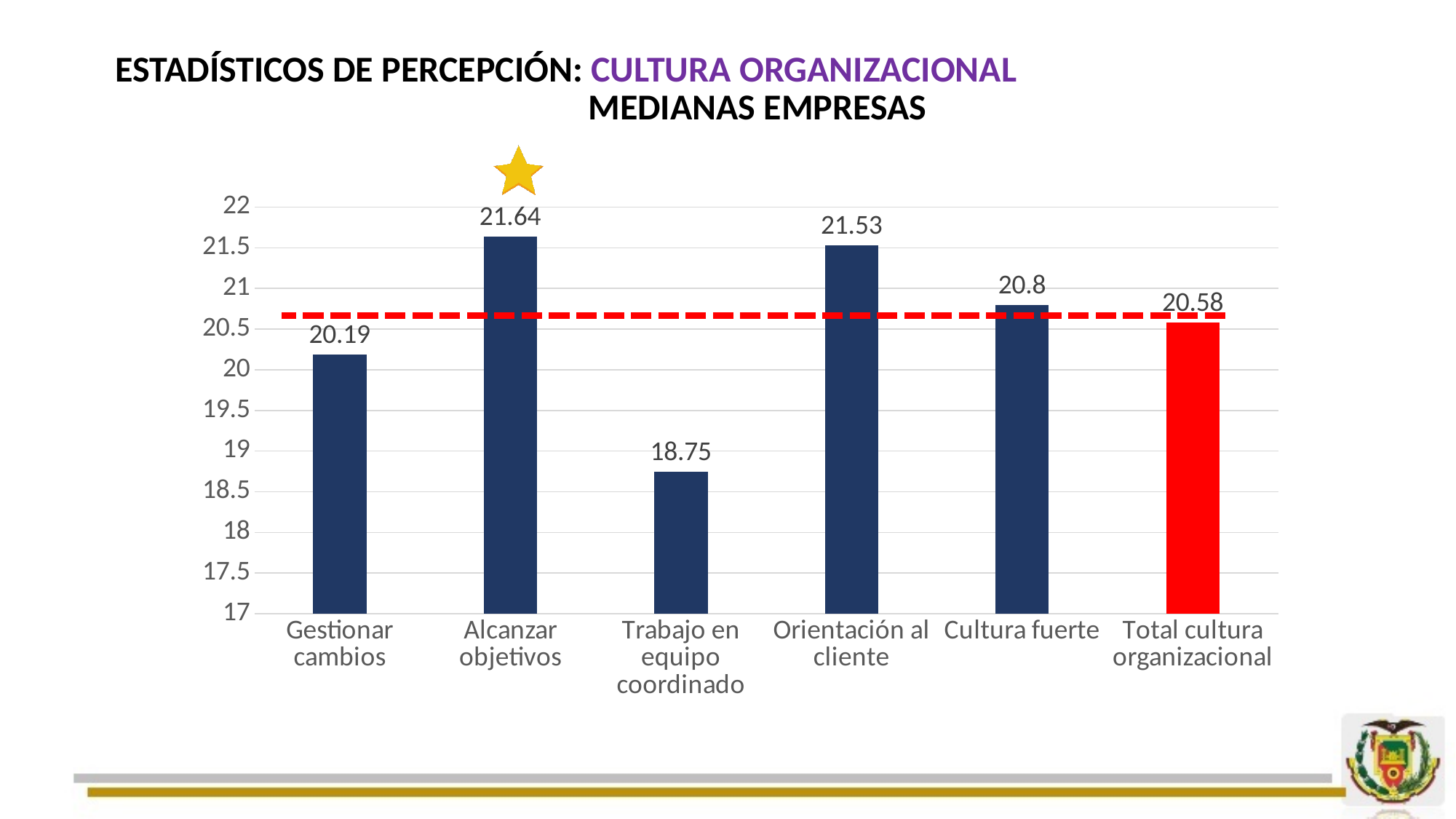
Is the value for Gestionar cambios greater or less than 20.5? less What kind of chart is this? bar chart Which is larger, Gestionar cambios or Orientación al cliente? Orientación al cliente What is the difference between Alcanzar objetivos and Trabajo en equipo coordinado? 2.89 What is the value for Trabajo en equipo coordinado? 18.75 What is the value for Alcanzar objetivos? 21.64 Which bar is coloured red instead of dark blue? Total cultura organizacional Which category has the lowest value? Trabajo en equipo coordinado What is the value for Cultura fuerte? 20.8 How many categories are shown on the x axis? 6 Which category has the highest value? Alcanzar objetivos What is the value for Total cultura organizacional? 20.58